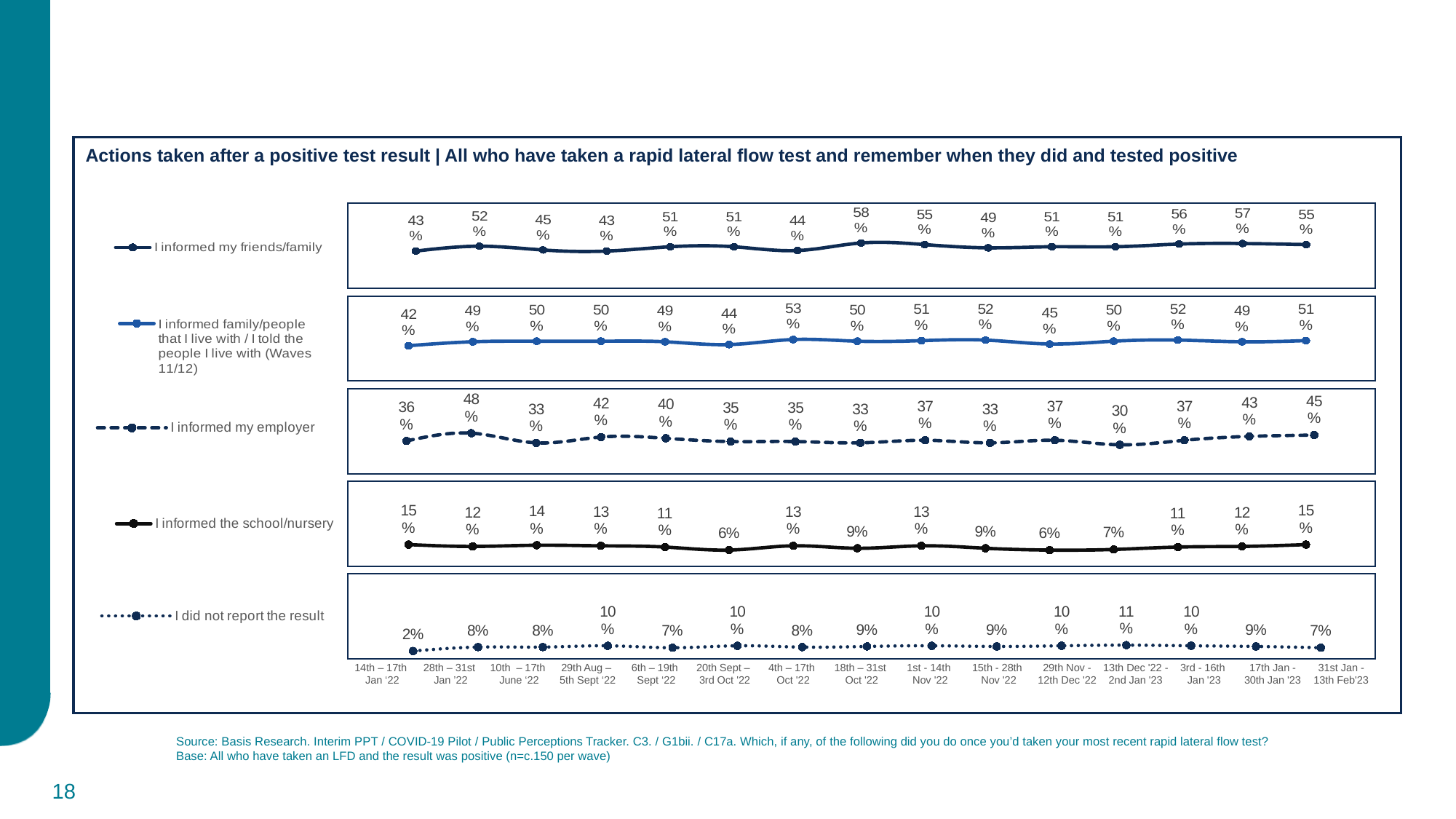
How many waves (data points) are plotted in each chart on the slide? 15 In the 'I did not report the result' chart, which wave has the lowest value? 14th – 17th Jan '22 In the 'I did not report the result' chart, what is the value for 13th Dec '22 - 2nd Jan '23? 11% In the 'I informed the school/nursery' chart, what is the difference between the value for 14th – 17th Jan '22 and the value for 20th Sept – 3rd Oct '22? 9% In the 'I informed my employer' chart, what is the value for 13th Dec '22 - 2nd Jan '23? 30% In the 'I informed my employer' chart, which wave has the highest value? 28th – 31st Jan '22 What kind of chart is used for 'I informed the school/nursery'? Line chart In the 'I informed family/people that I live with' chart, what is the value for 4th – 17th Oct '22? 53% In the 'I informed my friends/family' chart, what is the value for 18th – 31st Oct '22? 58% In the 'I informed my employer' chart, which is larger: the value for 17th Jan - 30th Jan '23 or the value for 31st Jan - 13th Feb '23? 31st Jan - 13th Feb '23 In the 'I informed my friends/family' chart, which wave has the highest value? 18th – 31st Oct '22 Which series on the slide is drawn with a dotted line? I did not report the result